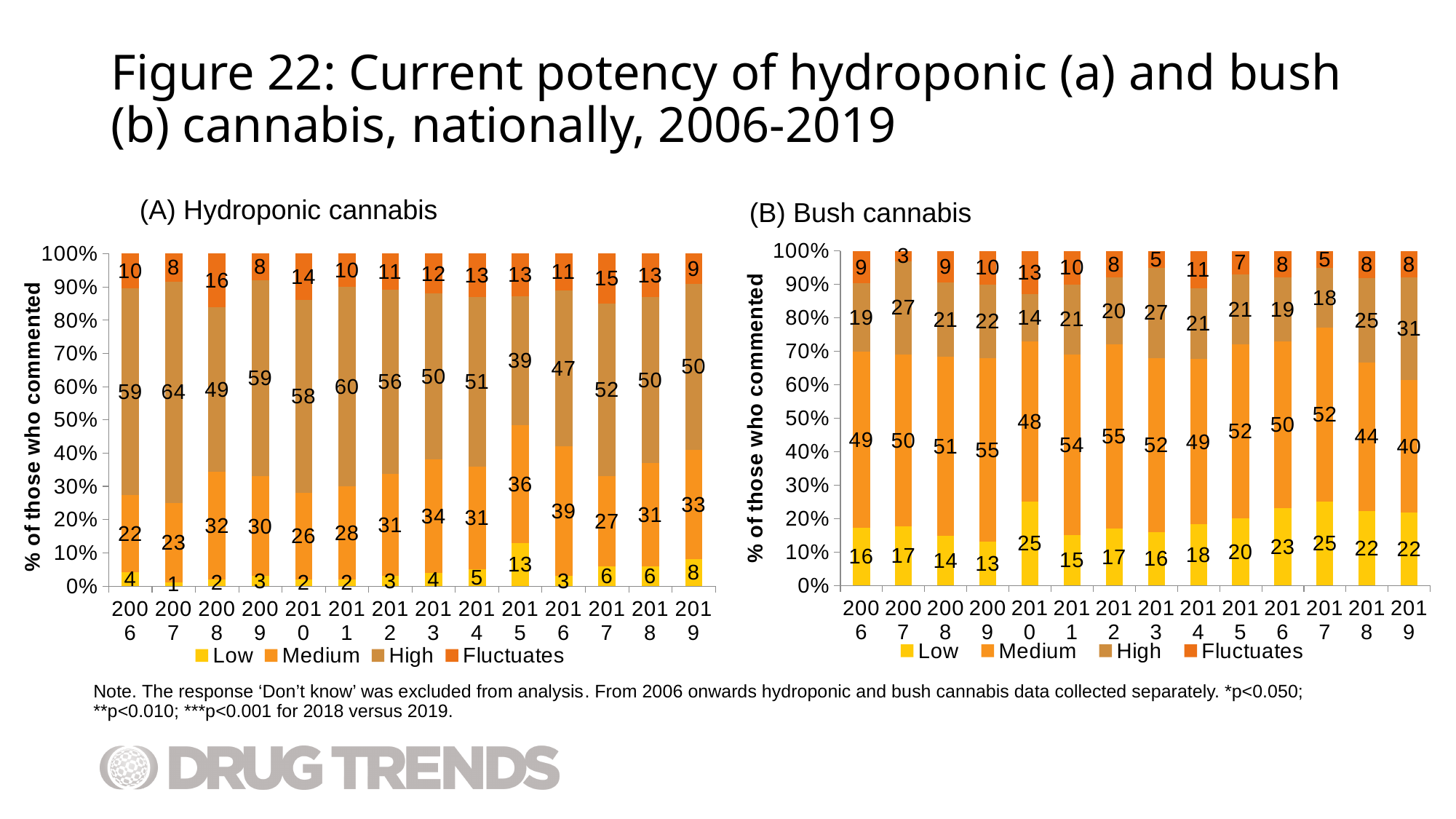
In the (B) Bush cannabis chart, what is the difference between the Low values for 2010 and 2009? 12 In the (A) Hydroponic cannabis chart, is the Fluctuates value larger in 2008 or in 2009? 2008 In the (A) Hydroponic cannabis chart, which year has the lowest High value? 2015 In the (B) Bush cannabis chart, which year has the highest High value? 2019 How many years are shown on the x axis of the (B) Bush cannabis chart? 14 In the (B) Bush cannabis chart, which year has the lowest Fluctuates value? 2007 In the (A) Hydroponic cannabis chart, what is the difference between the Medium values for 2016 and 2006? 17 How many series does the legend of the (A) Hydroponic cannabis chart list? 4 In the (B) Bush cannabis chart, what is the Medium value for 2019? 40 In the (A) Hydroponic cannabis chart, which year has the highest Low value? 2015 In the (A) Hydroponic cannabis chart, what percentage of those who commented rated potency as High in 2007? 64 What kind of chart is the (B) Bush cannabis chart? Stacked bar chart